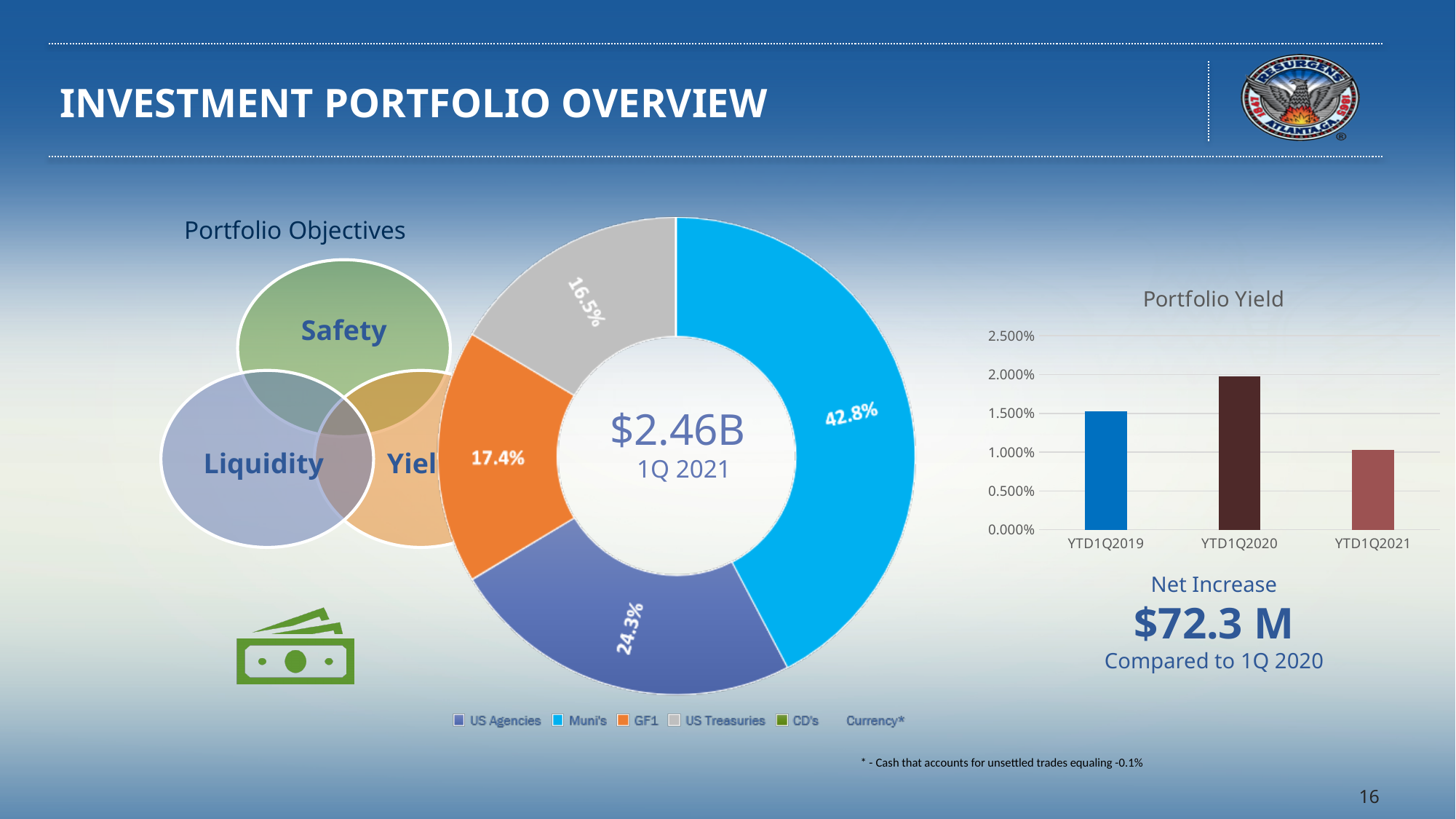
In the pie chart, what is the difference in percentage points between the Muni's slice and the US Agencies slice? 18.5 What total portfolio value is shown in the centre of the pie chart? $2.46B In the Portfolio Yield chart, which period has the lowest yield? YTD1Q2021 How many entries does the legend of the pie chart list? 6 In the pie chart, what share of the portfolio is GF1? 17.4% In the pie chart, which of GF1 or US Treasuries has the larger slice? GF1 What kind of chart is the Portfolio Yield chart? bar chart In the Portfolio Yield chart, which period has the highest yield? YTD1Q2020 In the pie chart, what share of the portfolio is Muni's? 42.8% In the pie chart, which category has the largest slice? Muni's In the Portfolio Yield chart, is the value for YTD1Q2021 greater or less than 1.500%? less In the pie chart, what share of the portfolio is US Agencies? 24.3%